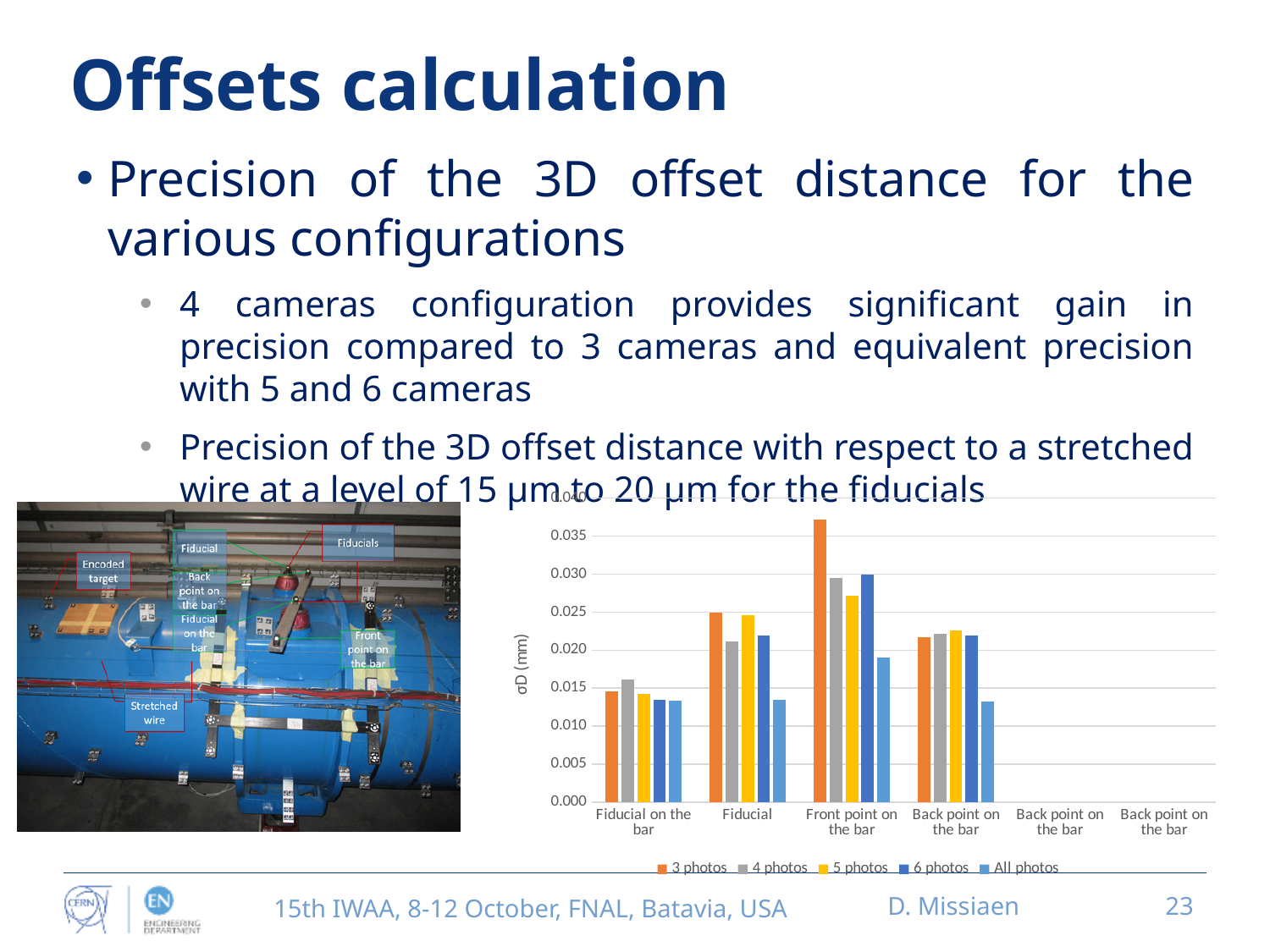
Which series in the chart's legend is shown in orange? 3 photos For Fiducial, which is larger: the 3 photos value or the 4 photos value? 3 photos Is the 5 photos value for Front point on the bar greater or less than 0.025? greater For Front point on the bar, which is larger: the 3 photos value or the All photos value? 3 photos How many categories on the x axis actually have bars plotted? 4 For which category is the 3 photos bar the highest? Front point on the bar Is the All photos value for Front point on the bar greater or less than 0.020? less What kind of chart is shown on the slide? bar chart How many series does the chart's legend list? 5 Is the 3 photos value for Front point on the bar greater or less than 0.035? greater What is the label of the chart's vertical axis? σD (mm)